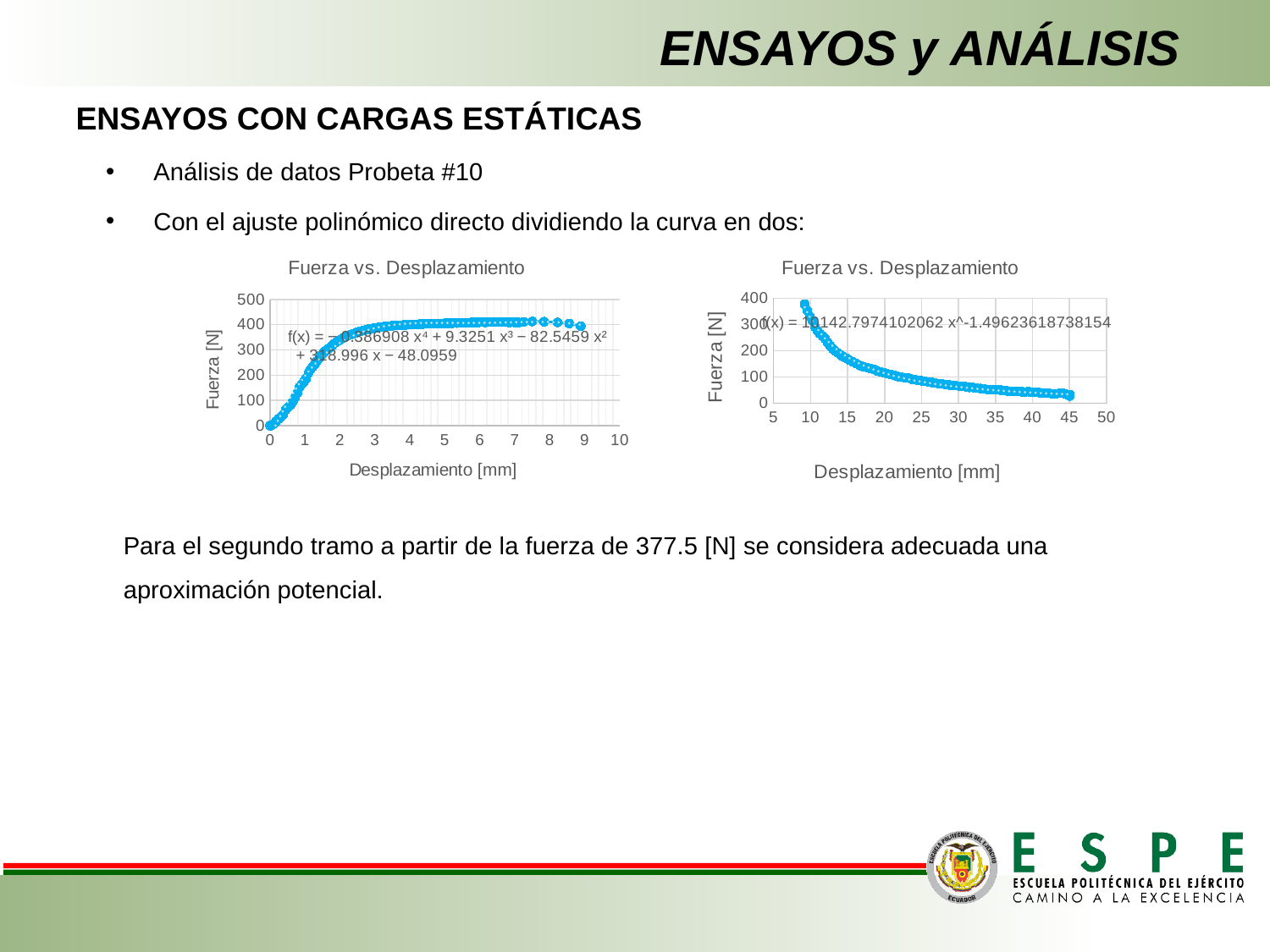
What is the x-axis title of the right chart? Desplazamiento [mm] What is the y-axis title of the left chart? Fuerza [N] In the right chart, is the force value at a displacement of 40 mm greater or less than 100? less In the left chart, is the force value at a displacement of 5 mm greater or less than 300? greater What kind of chart is the left chart titled 'Fuerza vs. Desplazamiento'? scatter chart In the right chart, do the values rise or fall as displacement increases along the x axis? fall What kind of chart is the right chart titled 'Fuerza vs. Desplazamiento'? scatter chart In the left chart, do the values rise or fall as displacement increases along the x axis? rise In the left chart, is the force value at a displacement of 1 mm greater or less than 300? less